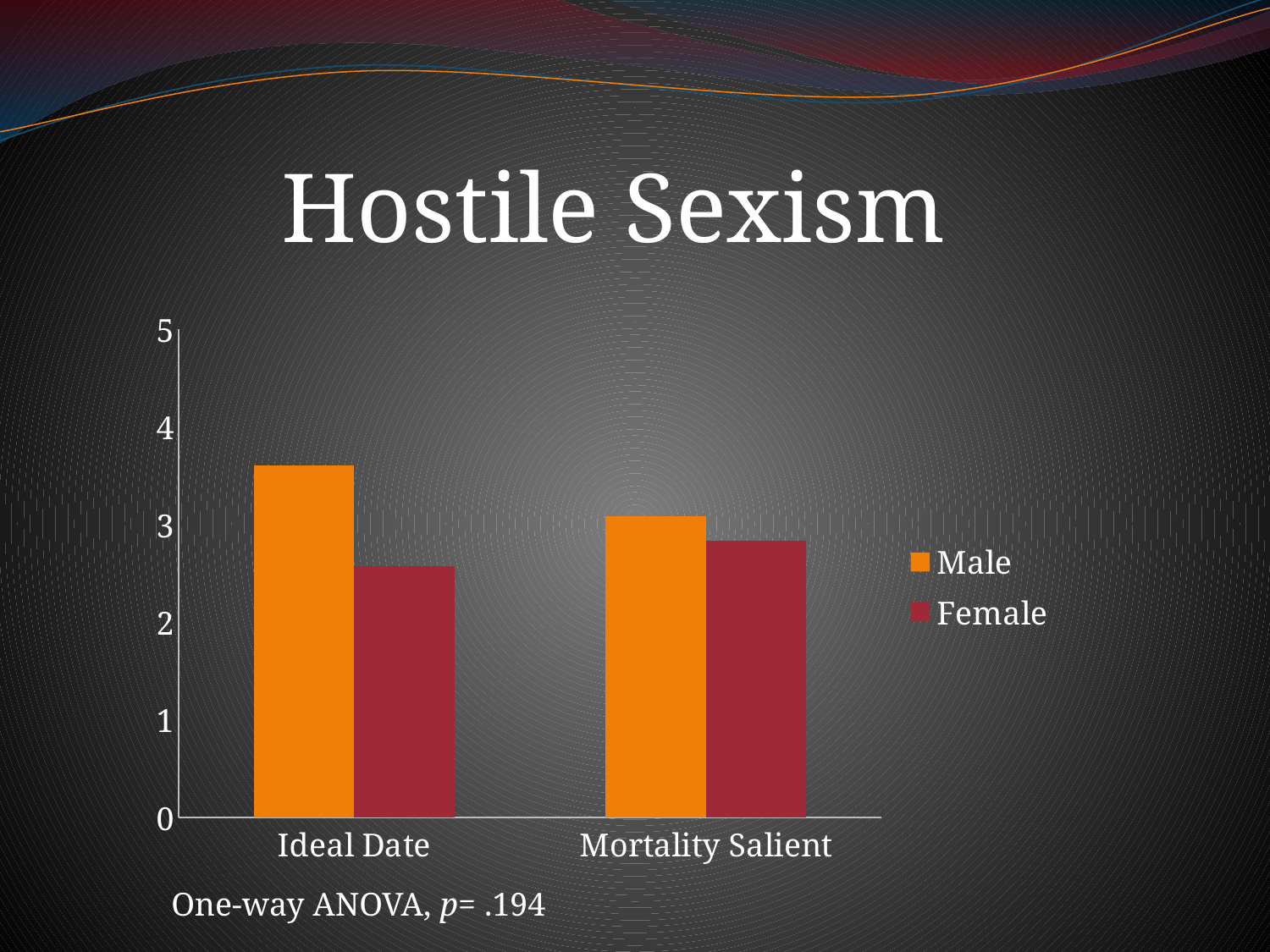
Is the Male value for Ideal Date greater or less than 4? less What is the title of the chart? Hostile Sexism Which bar is the tallest in the chart? Male, Ideal Date What kind of chart is shown on the slide? Bar chart For Ideal Date, which is larger, the Male value or the Female value? Male How many categories are shown on the x axis? 2 Is the Female value for Ideal Date greater or less than 3? less Which colour represents the Male series in the legend? Orange Is the Male value for Ideal Date greater or less than 3? greater Does the Male series rise or fall from Ideal Date to Mortality Salient? Fall How many series does the legend list? 2